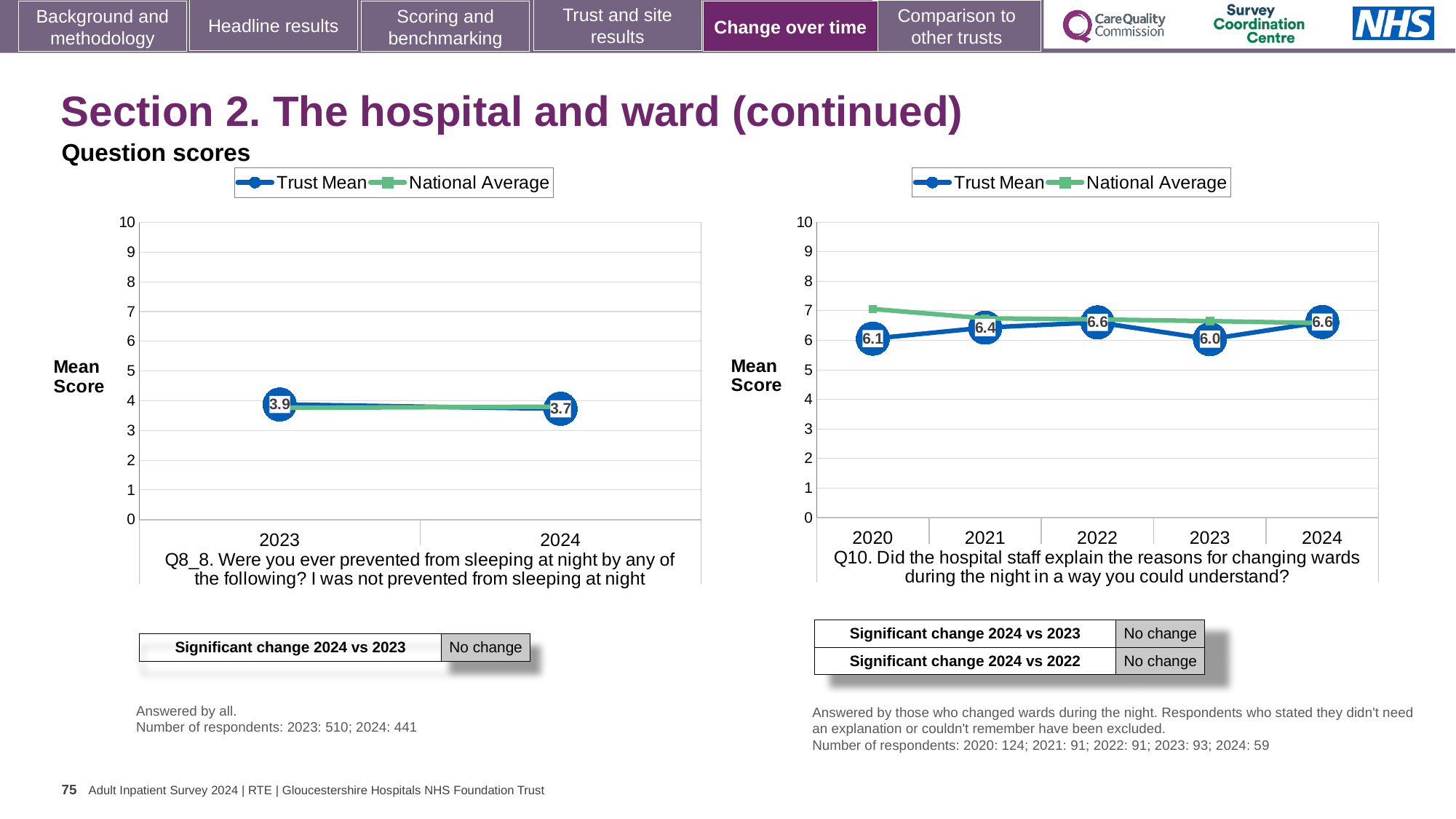
In the left chart (Q8_8), does the Trust Mean rise or fall from 2023 to 2024? fall How many series does the legend of the left chart (Q8_8) list? 2 In the left chart (Q8_8), what is the Trust Mean for 2023? 3.9 In the right chart (Q10), which year has the lowest Trust Mean? 2023 In the left chart (Q8_8), what is the difference between the Trust Mean for 2023 and 2024? 0.2 In the right chart (Q10), what is the Trust Mean for 2020? 6.1 How many years are plotted on the x axis of the right chart (Q10)? 5 In the right chart (Q10), what is the difference between the Trust Mean for 2021 and 2023? 0.4 In the right chart (Q10), what is the Trust Mean for 2023? 6.0 In the right chart (Q10), is the Trust Mean for 2022 larger or smaller than the Trust Mean for 2020? larger In the right chart (Q10), is the National Average for 2020 greater or less than 6? greater In the left chart (Q8_8), what is the Trust Mean for 2024? 3.7